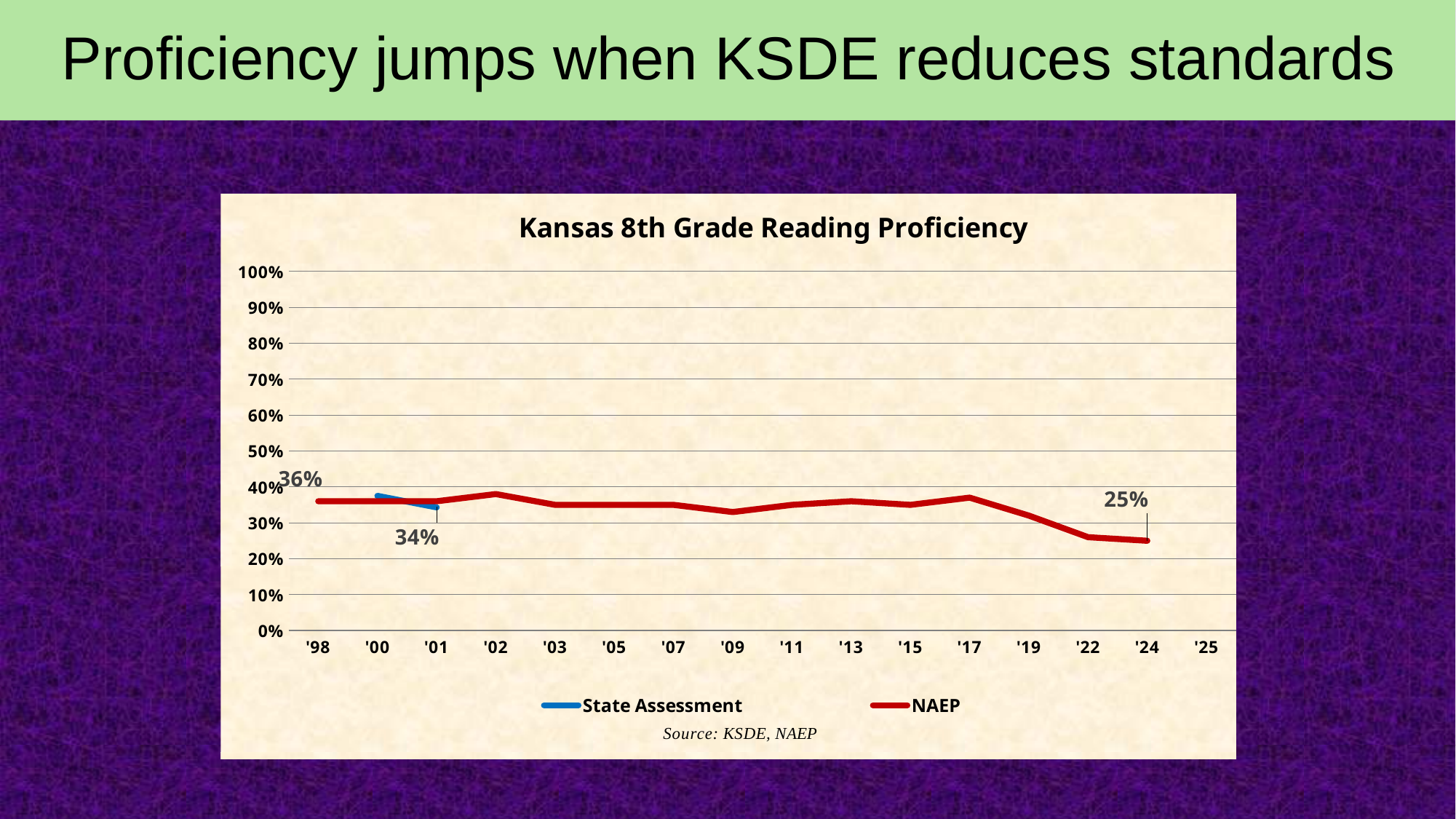
Is the NAEP value for '22 greater or less than 30%? less Is the NAEP value for '17 greater or less than 30%? greater What is the State Assessment proficiency value for '01? 34% Which is larger, the NAEP value for '98 or the NAEP value for '24? '98 What is the title of the chart? Kansas 8th Grade Reading Proficiency In which year does the NAEP line reach its lowest value? '24 How many series does the legend list? 2 What kind of chart is shown on the slide? line chart What is the NAEP proficiency value for '24? 25% What is the NAEP proficiency value for '98? 36% Does the NAEP line rise or fall from '17 to '24? fall What is the difference between the NAEP value for '98 and the NAEP value for '24? 11 percentage points